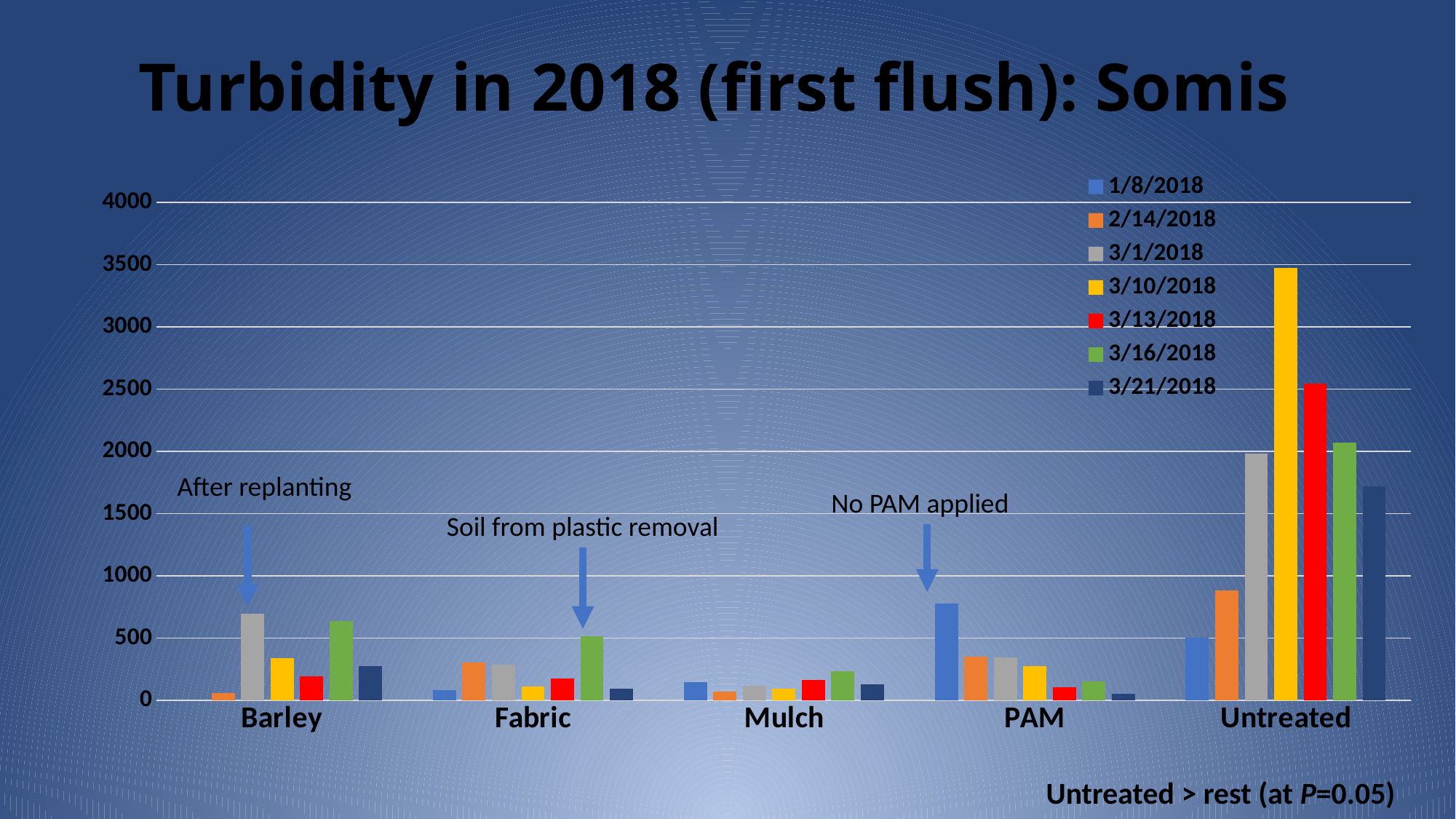
Is the value for Untreated on 3/10/2018 greater or less than 3000? greater Is the value for Untreated on 3/13/2018 greater or less than 2000? greater Which is larger: the 3/1/2018 value for Untreated or the 3/1/2018 value for Barley? Untreated How many series does the legend list? 7 Which series has the highest value within the Untreated category? 3/10/2018 How many treatment categories are shown on the x axis? 5 Within the Fabric category, which is larger: the 3/16/2018 value or the 1/8/2018 value? 3/16/2018 Is the value for Barley on 3/1/2018 greater or less than 500? greater What annotation is written above the Fabric bars? Soil from plastic removal Which category has the highest value for the 3/10/2018 series? Untreated What kind of chart is shown on the slide? bar chart